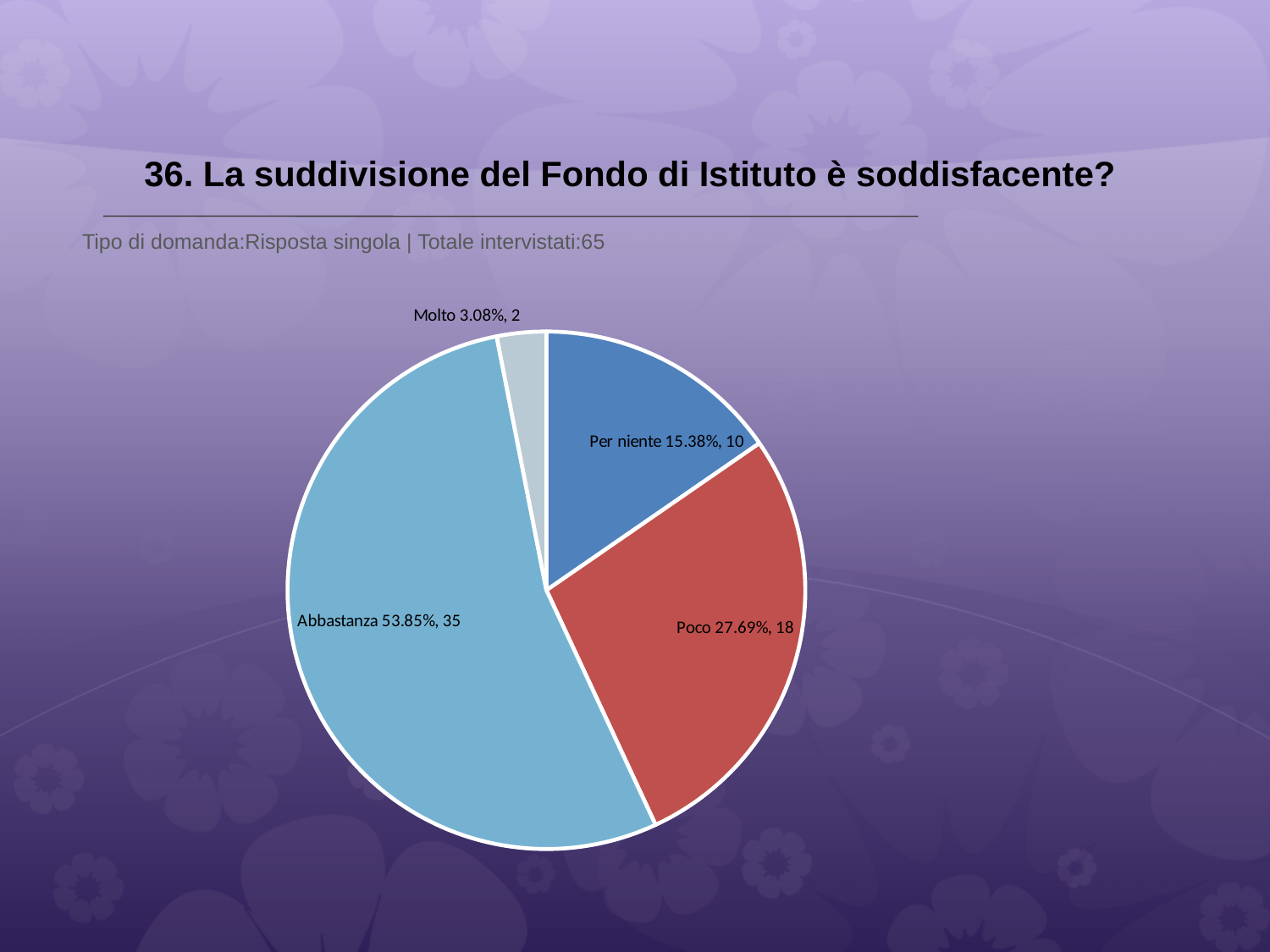
Which response has the largest share of the pie? Abbastanza How many response categories are shown in the pie chart? 4 Which response has the smallest share of the pie? Molto What is the share of the pie for the "Abbastanza" slice? 53.85% What is the title of the chart on the slide? 36. La suddivisione del Fondo di Istituto è soddisfacente? How many respondents answered "Abbastanza"? 35 How many more respondents answered "Poco" than "Per niente"? 8 What percentage of respondents answered "Poco"? 27.69% What kind of chart is shown on the slide? Pie chart How many respondents answered "Per niente"? 10 What percentage of respondents answered "Molto"? 3.08% Which response received more answers, "Per niente" or "Poco"? Poco